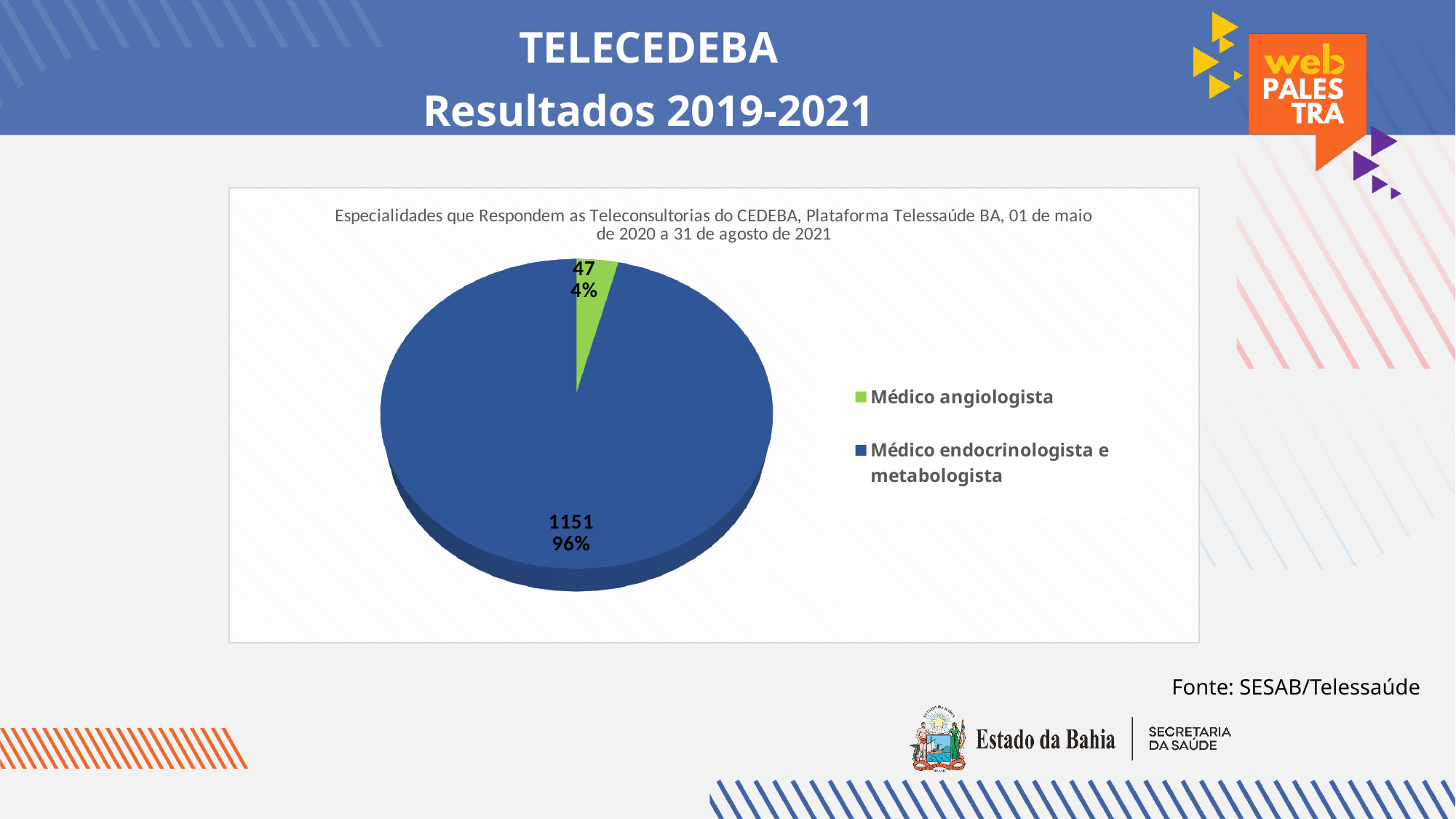
What kind of chart is shown on the slide? Pie chart Which is larger, the value for Médico angiologista or for Médico endocrinologista e metabologista? Médico endocrinologista e metabologista How many slices does the pie chart have? 2 What is the value for Médico angiologista? 47 What is the value for Médico endocrinologista e metabologista? 1151 What share of the pie does Médico angiologista represent? 4% Which specialty has the smallest slice? Médico angiologista How many entries does the legend list? 2 What share of the pie does Médico endocrinologista e metabologista represent? 96% What colour is the slice for Médico angiologista? Green Which specialty has the largest slice? Médico endocrinologista e metabologista What is the difference between the values for Médico endocrinologista e metabologista and Médico angiologista? 1104